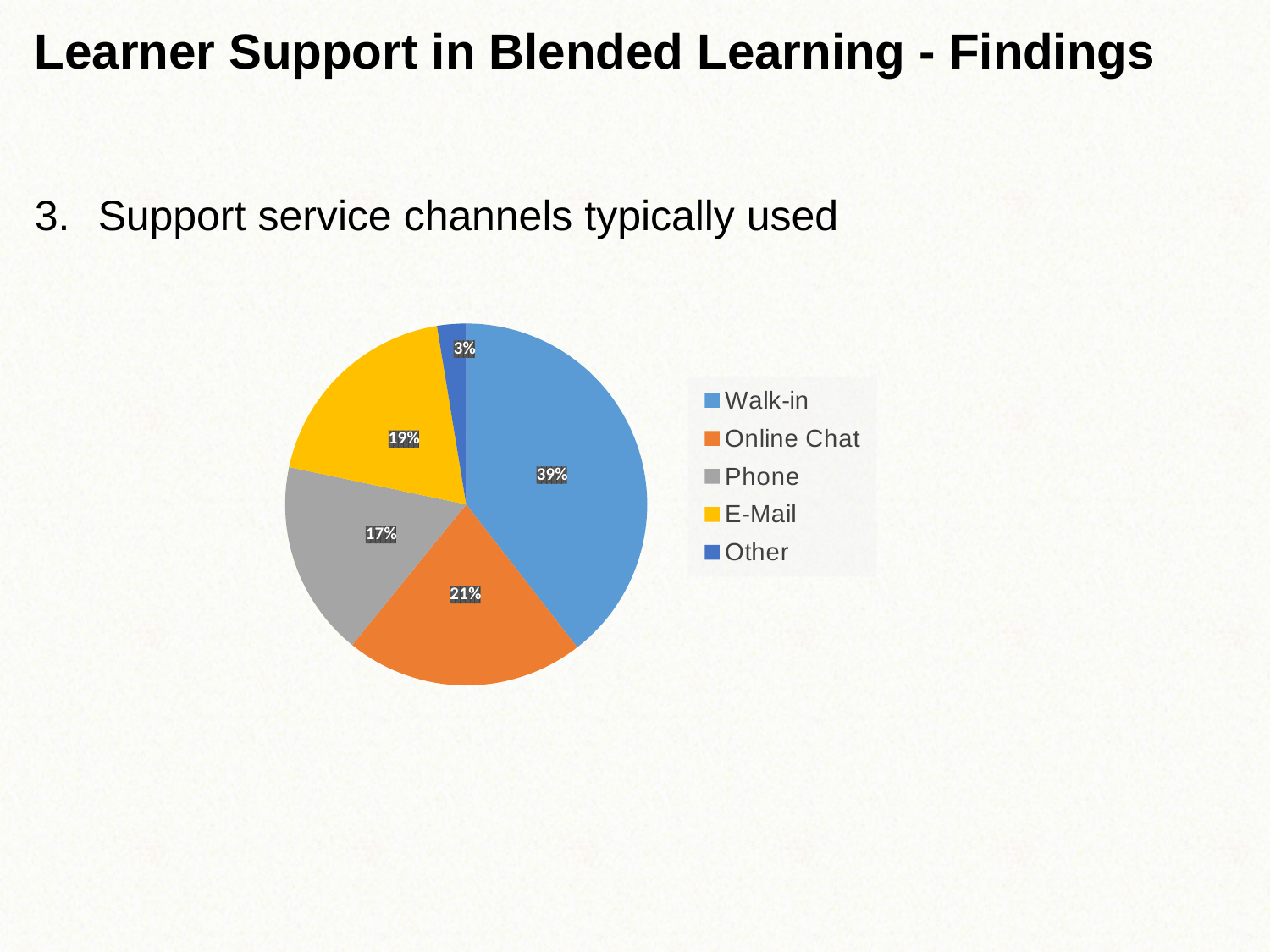
What share of the pie does Online Chat have? 21% What share of the pie does Other have? 3% What share of the pie does Walk-in have? 39% Which support channel has the largest share? Walk-in Which colour represents Online Chat in the legend? orange What is the difference in percentage points between Walk-in and Online Chat? 18 How many slices does the pie chart have? 5 Which support channel has the smallest share? Other What kind of chart is shown on the slide? pie chart Which has a larger share, E-Mail or Phone? E-Mail